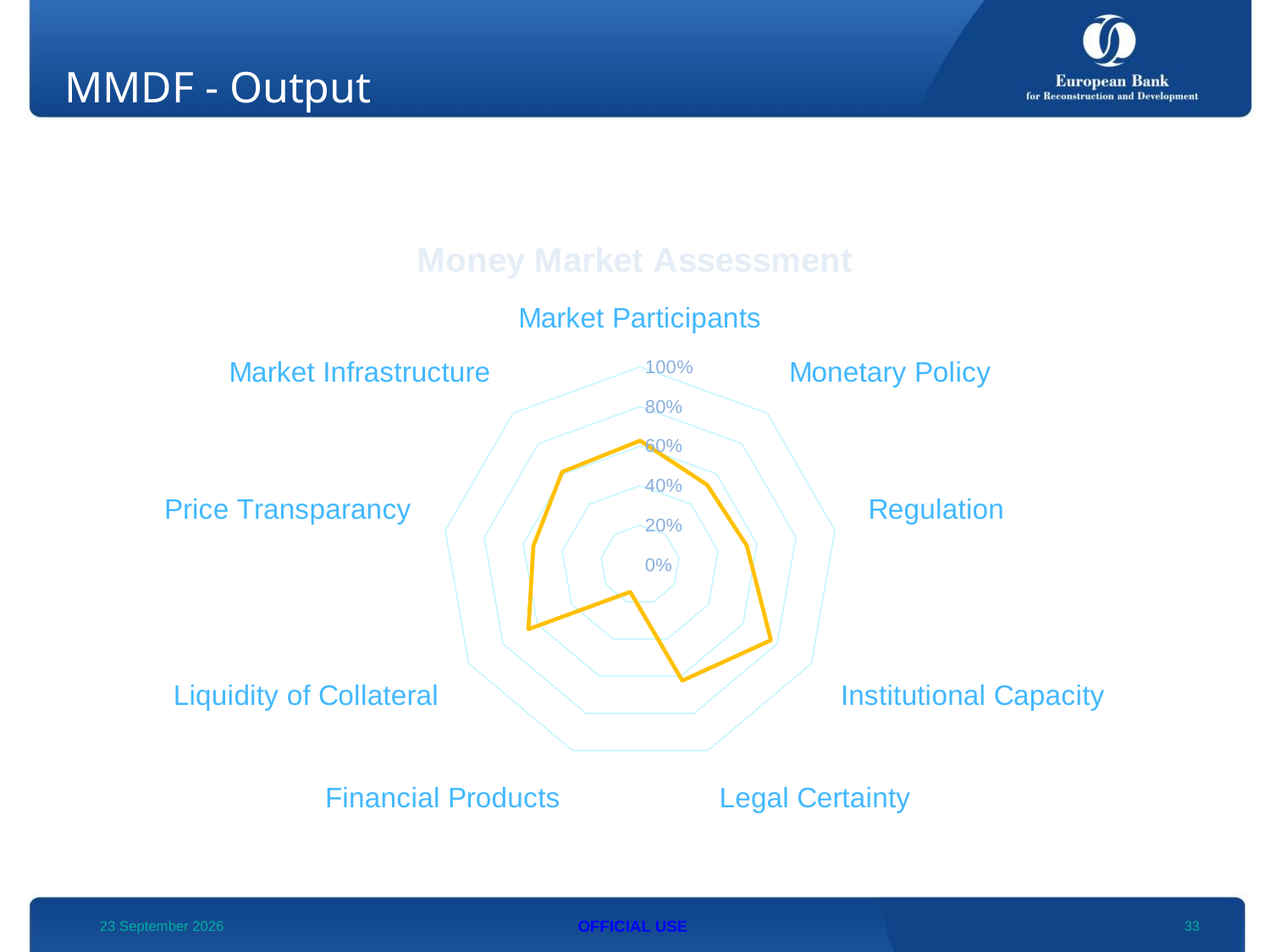
Which is larger, the value for Liquidity of Collateral or the value for Monetary Policy? Liquidity of Collateral What is the maximum value shown on the chart's percentage scale? 100% Which category has the lowest value on the chart? Financial Products Is the value for Liquidity of Collateral greater or less than 40%? greater What kind of chart is shown on the slide? Radar chart Which is larger, the value for Institutional Capacity or the value for Financial Products? Institutional Capacity Is the value for Institutional Capacity greater or less than 40%? greater Is the value for Financial Products greater or less than 40%? less What is the title of the chart? Money Market Assessment How many categories (axes) does the radar chart have? 9